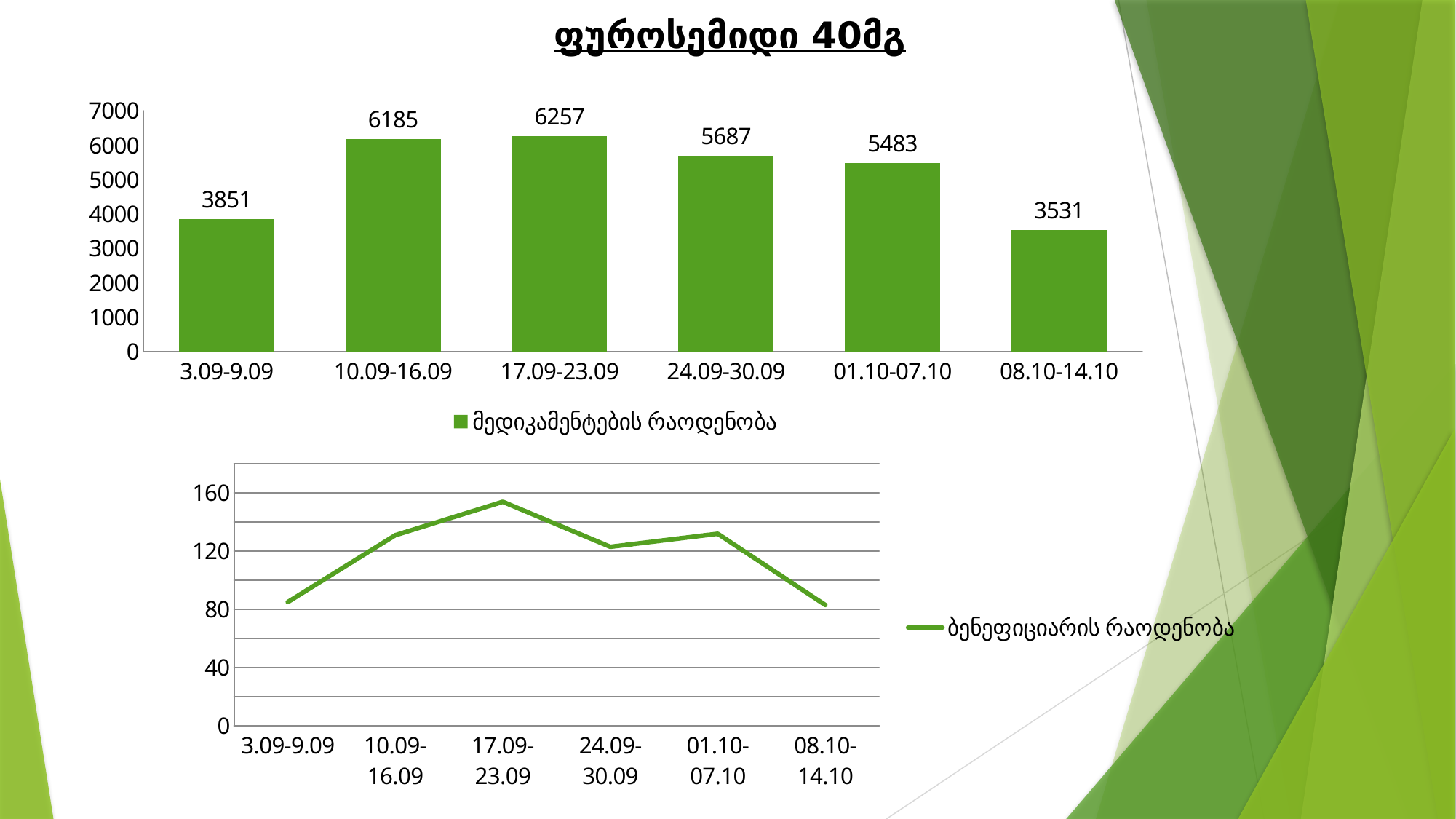
What kind of chart is the top chart on the slide? bar chart In the bottom line chart, which period has the highest value? 17.09-23.09 In the bottom line chart, is the value for 10.09-16.09 greater or less than 120? greater What is the legend entry of the bottom line chart? ბენეფიციარის რაოდენობა In the top bar chart, what is the value for 01.10-07.10? 5483 In the top bar chart, which period has the highest value? 17.09-23.09 In the top bar chart, which period has the lowest value? 08.10-14.10 What kind of chart is the bottom chart on the slide? line chart In the top bar chart, what is the value for 3.09-9.09? 3851 How many periods are shown in the top bar chart? 6 In the top bar chart, what is the difference between the values for 17.09-23.09 and 10.09-16.09? 72 In the top bar chart, which is larger, the value for 24.09-30.09 or the value for 01.10-07.10? 24.09-30.09